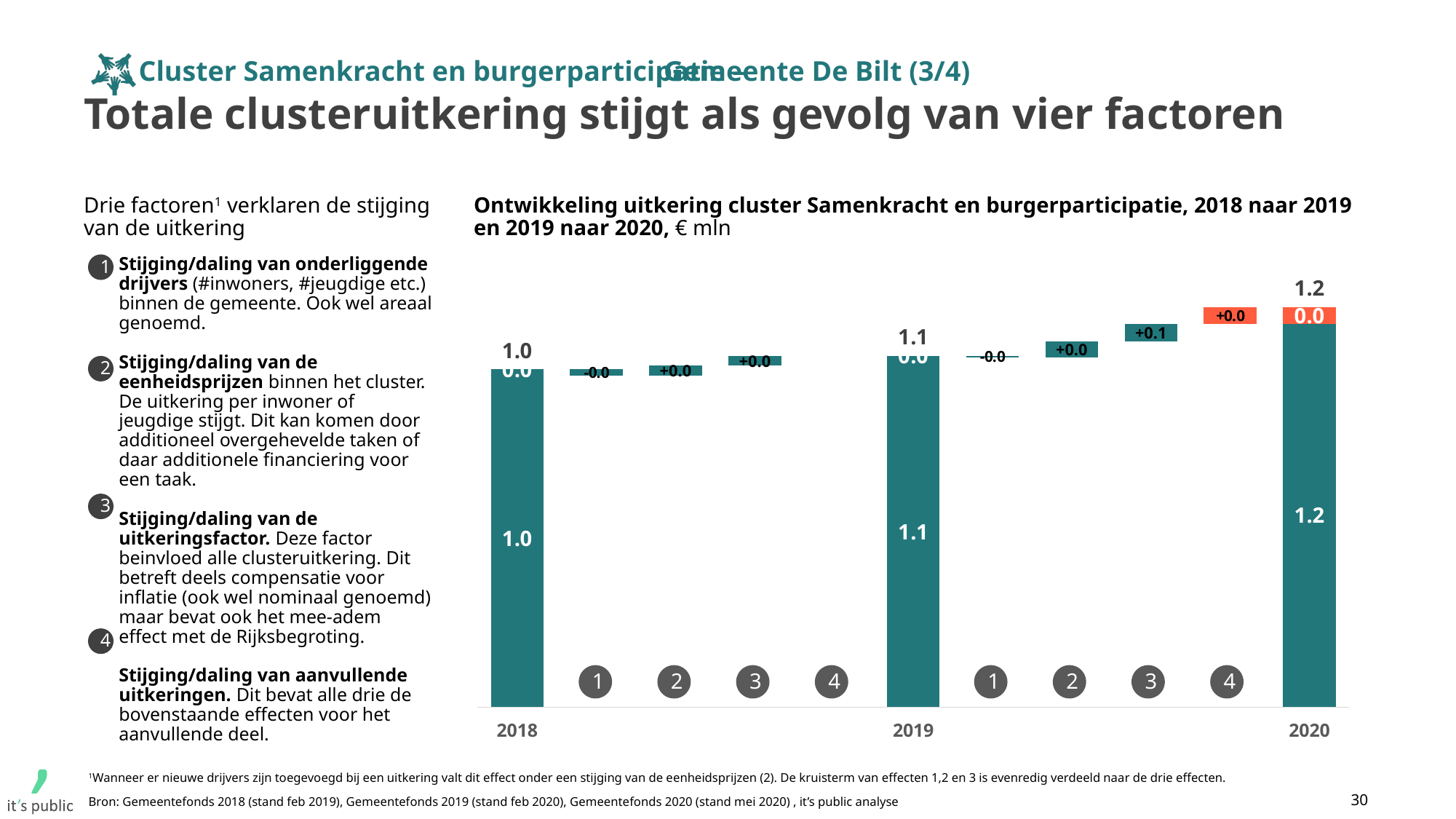
What is the value of factor 4 (orange bar) in the step from 2019 to 2020? +0.0 Do the yearly totals rise or fall from 2018 to 2020? rise What is the value of factor 3 (uitkeringsfactor) in the step from 2019 to 2020? +0.1 What is the value of factor 1 in the step from 2019 to 2020? -0.0 In what unit are the values in the chart expressed? € mln What is the total cluster payout shown for 2019? 1.1 Which year has the highest total cluster payout? 2020 Which year has the lowest total cluster payout? 2018 What is the total cluster payout shown for 2020? 1.2 What kind of chart is shown on the slide? bar chart (waterfall) What is the difference between the 2020 total and the 2018 total? 0.2 What is the total cluster payout shown for 2018? 1.0